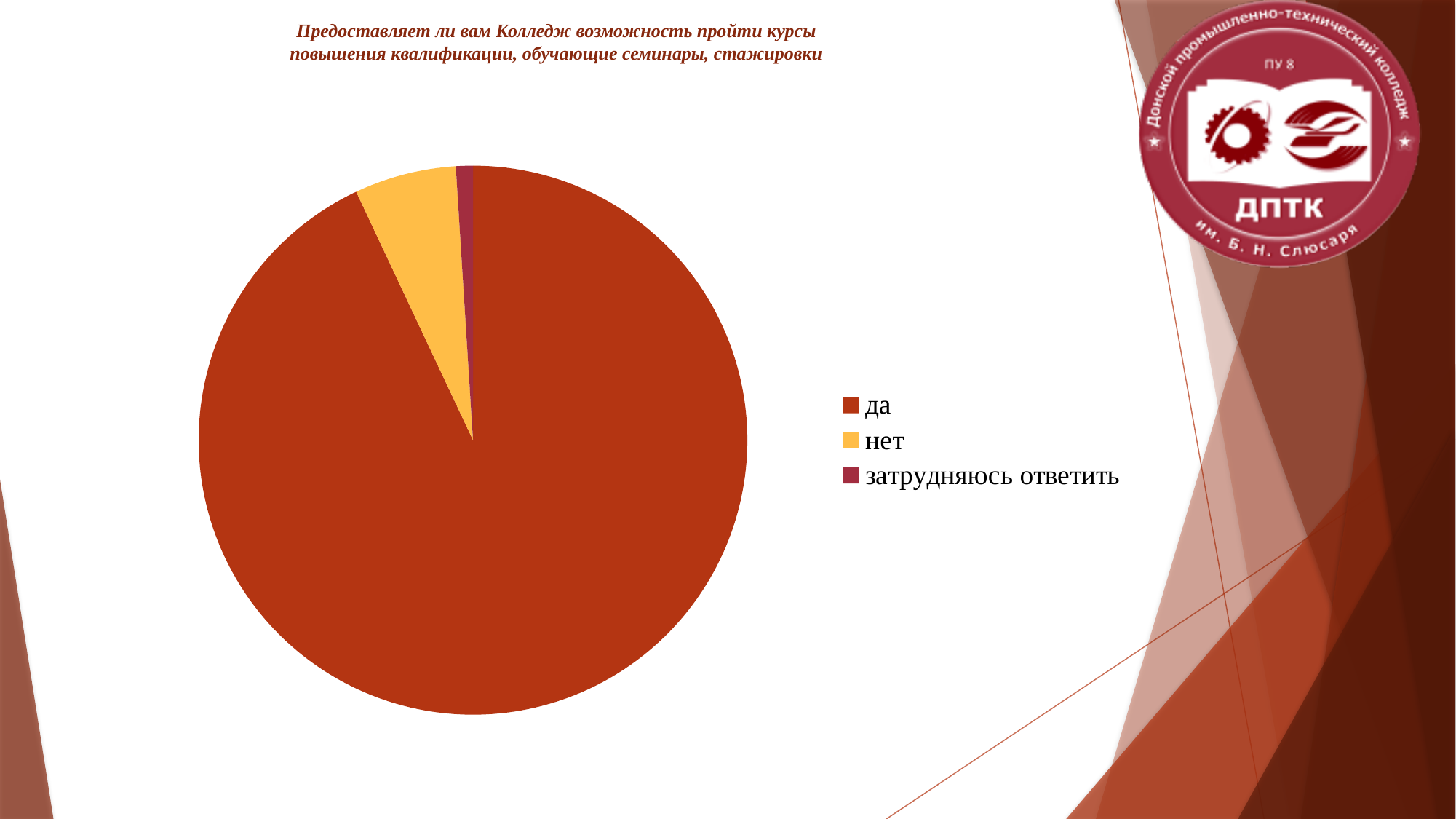
Which slice is larger in the pie chart, "да" or "нет"? да Which category has the largest slice in the pie chart? да How many entries does the legend of the pie chart list? 3 Which category has the smallest slice in the pie chart? затрудняюсь ответить What colour is the "нет" slice in the pie chart? yellow How many slices does the pie chart have? 3 Which slice is larger in the pie chart, "нет" or "затрудняюсь ответить"? нет What kind of chart is shown on the slide? pie chart What are the three legend entries of the pie chart? да, нет, затрудняюсь ответить